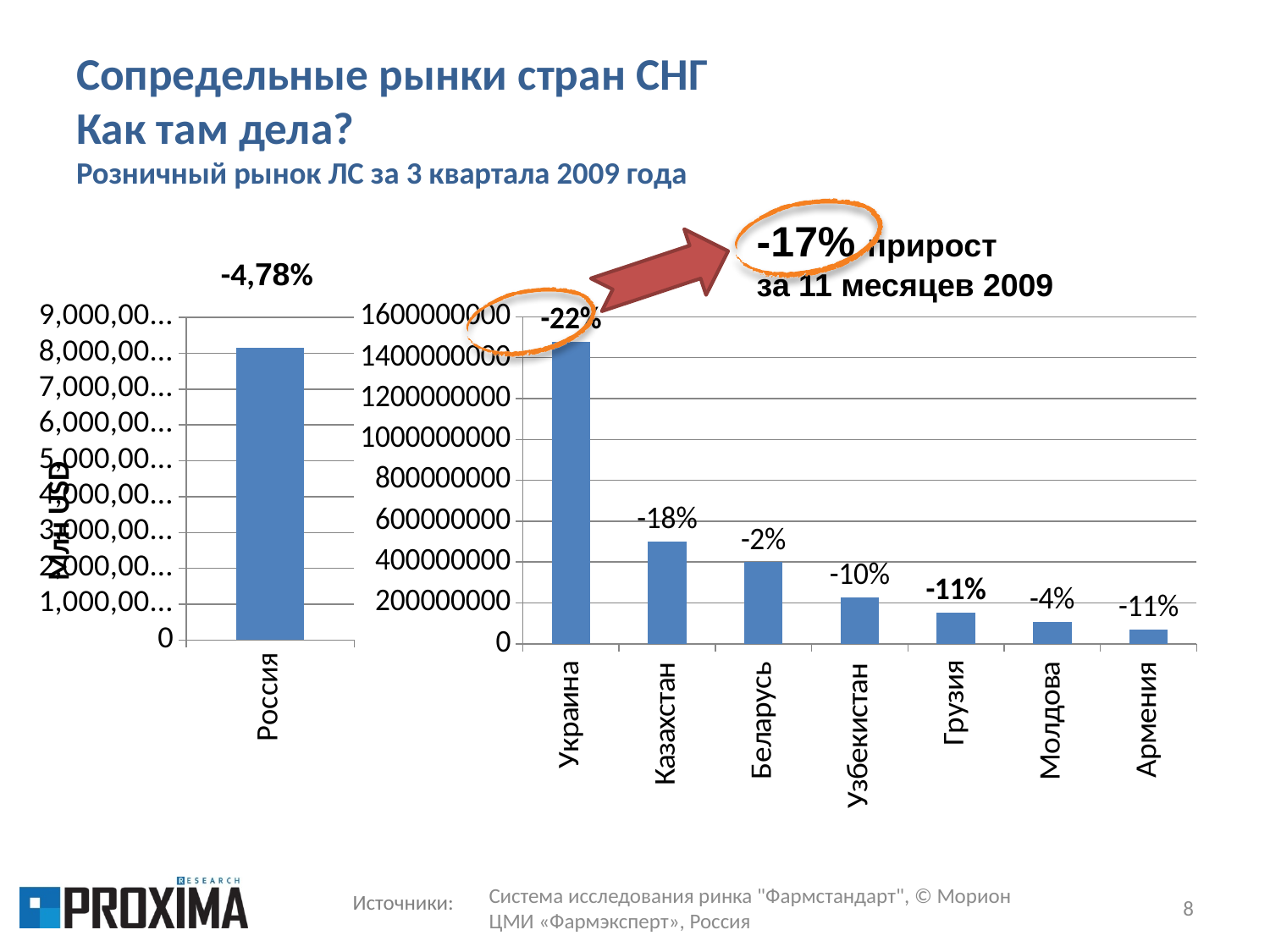
In the right-hand chart, which bar is taller: Казахстан or Беларусь? Казахстан In the right-hand chart, which country has the lowest bar? Армения In the right-hand chart, is the value for Узбекистан greater or less than 200000000? greater What kind of chart is the right-hand chart showing Украина through Армения? bar chart In the right-hand chart, is the value for Украина greater or less than 1200000000? greater In the right-hand chart, what percentage label is printed above the Казахстан bar? -18% In the right-hand chart, which country has the highest bar? Украина In the right-hand chart, how many countries are shown on the x axis? 7 In the left-hand chart, what percentage label is printed above the Россия bar? -4,78% In the right-hand chart, is the value for Грузия greater or less than 200000000? less What is the y-axis title of the left-hand chart showing Россия? Млн USD In the right-hand chart, what percentage label is printed above the Беларусь bar? -2%